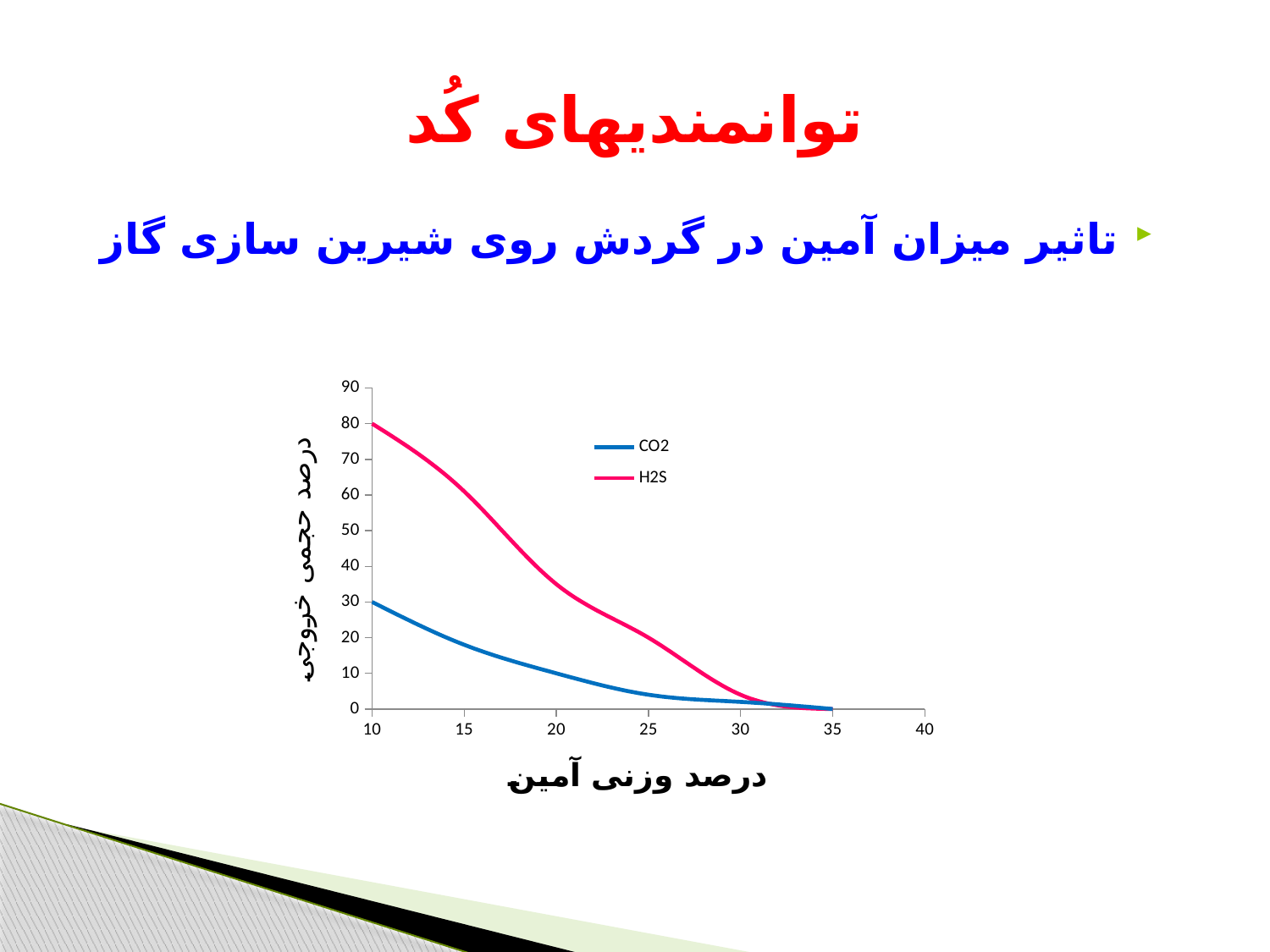
What are the two series named in the chart legend? CO2 and H2S Do the values of the H2S line rise or fall as the x-axis value increases? fall How many series does the chart legend list? 2 Is the value of the H2S line at x = 25 greater or less than 30? less What kind of chart is shown on the slide? line chart Do the values of the CO2 line rise or fall as the x-axis value increases? fall Is the value of the CO2 line at x = 20 greater or less than 20? less Which colour is used for the H2S line? pink Is the value of the CO2 line at x = 15 greater or less than 10? greater At x = 10, which series has the higher value, CO2 or H2S? H2S At x = 20, which series has the lower value, CO2 or H2S? CO2